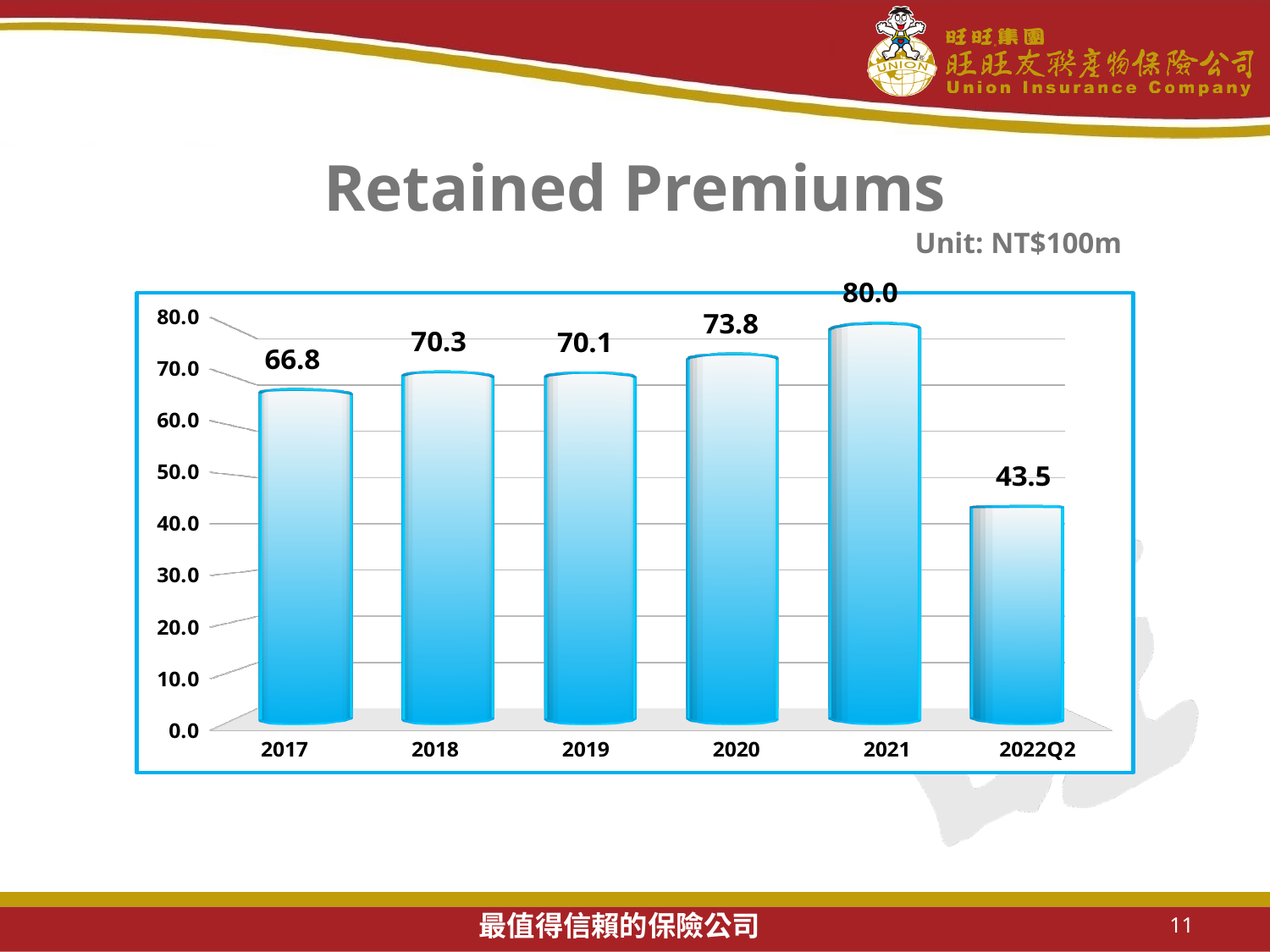
Which year has the highest retained premiums? 2021 Which category has the lowest retained premiums? 2022Q2 What is the difference between the retained premiums in 2018 and 2017? 3.5 What is the difference between the retained premiums in 2021 and 2020? 6.2 What is the retained premium value for 2021? 80.0 Is the value for 2022Q2 greater or less than 50.0? less Which is larger, the retained premiums in 2020 or in 2019? 2020 What is the retained premium value for 2017? 66.8 What kind of chart is shown on the slide? bar chart How many categories are shown on the x axis? 6 What is the retained premium value for 2022Q2? 43.5 What unit is stated for the chart values? NT$100m